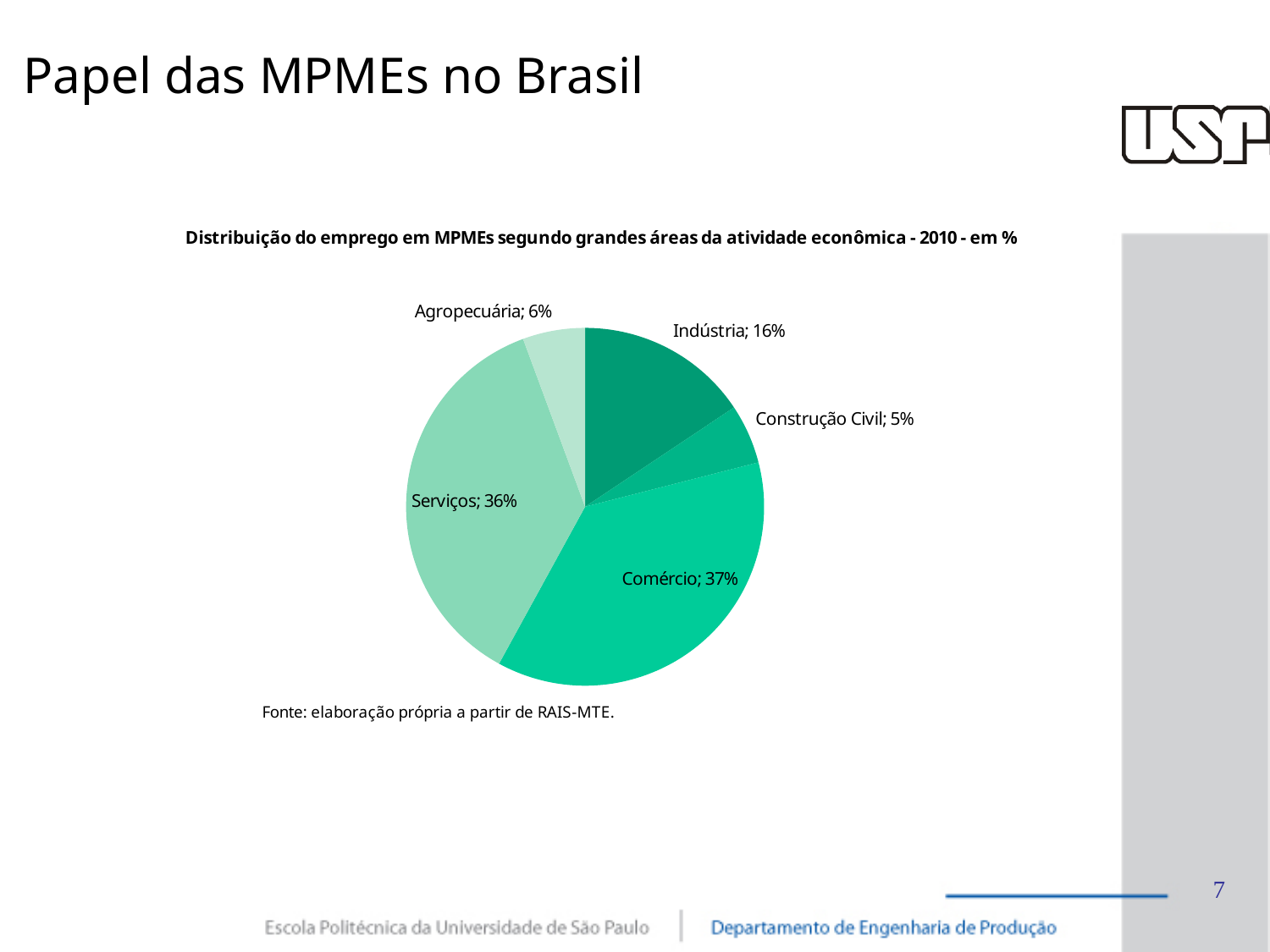
What percentage is shown for Agropecuária? 6% Which sector has the smallest slice of the pie chart? Construção Civil What is the difference in percentage points between Serviços and Indústria? 20 What is the value for Construção Civil in the pie chart? 5% What is the value shown for Serviços in the pie chart? 36% What share of employment does Comércio account for in the pie chart? 37% What year does the chart title say the data refers to? 2010 How many sectors are shown in the pie chart? 5 What percentage is shown for Indústria? 16% Which is larger, the share for Indústria or the share for Agropecuária? Indústria What kind of chart is shown on the slide? pie chart Which sector has the largest slice of the pie chart? Comércio